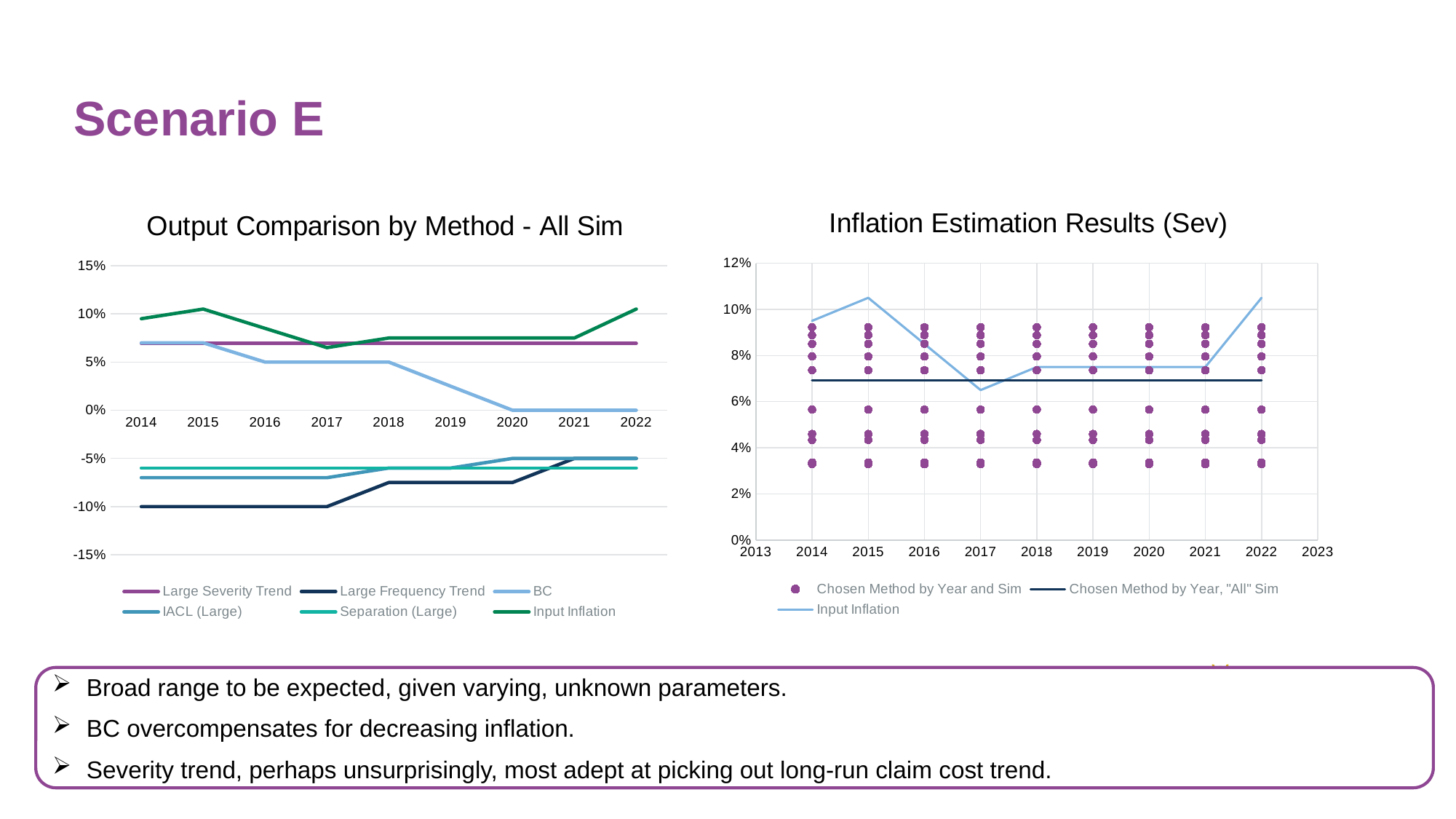
In the 'Inflation Estimation Results (Sev)' chart, in which year is the Input Inflation line at its lowest? 2017 In the 'Output Comparison by Method - All Sim' chart, how many series does the legend list? 6 In the 'Output Comparison by Method - All Sim' chart, does the BC line rise or fall from 2015 to 2020? fall In the 'Output Comparison by Method - All Sim' chart, how many years are shown on the x axis? 9 In the 'Output Comparison by Method - All Sim' chart, which is higher in 2022: Input Inflation or BC? Input Inflation In the 'Output Comparison by Method - All Sim' chart, what is the BC value in 2020? 0% In the 'Output Comparison by Method - All Sim' chart, what is the Large Frequency Trend value in 2014? -10% In the 'Output Comparison by Method - All Sim' chart, what kind of chart is shown? line chart In the 'Inflation Estimation Results (Sev)' chart, how many series does the legend list? 3 In the 'Inflation Estimation Results (Sev)' chart, is the Input Inflation value in 2017 greater or less than 8%? less In the 'Output Comparison by Method - All Sim' chart, is the Large Severity Trend value in 2018 greater or less than 5%? greater In the 'Output Comparison by Method - All Sim' chart, is the Input Inflation value in 2015 greater or less than 10%? greater